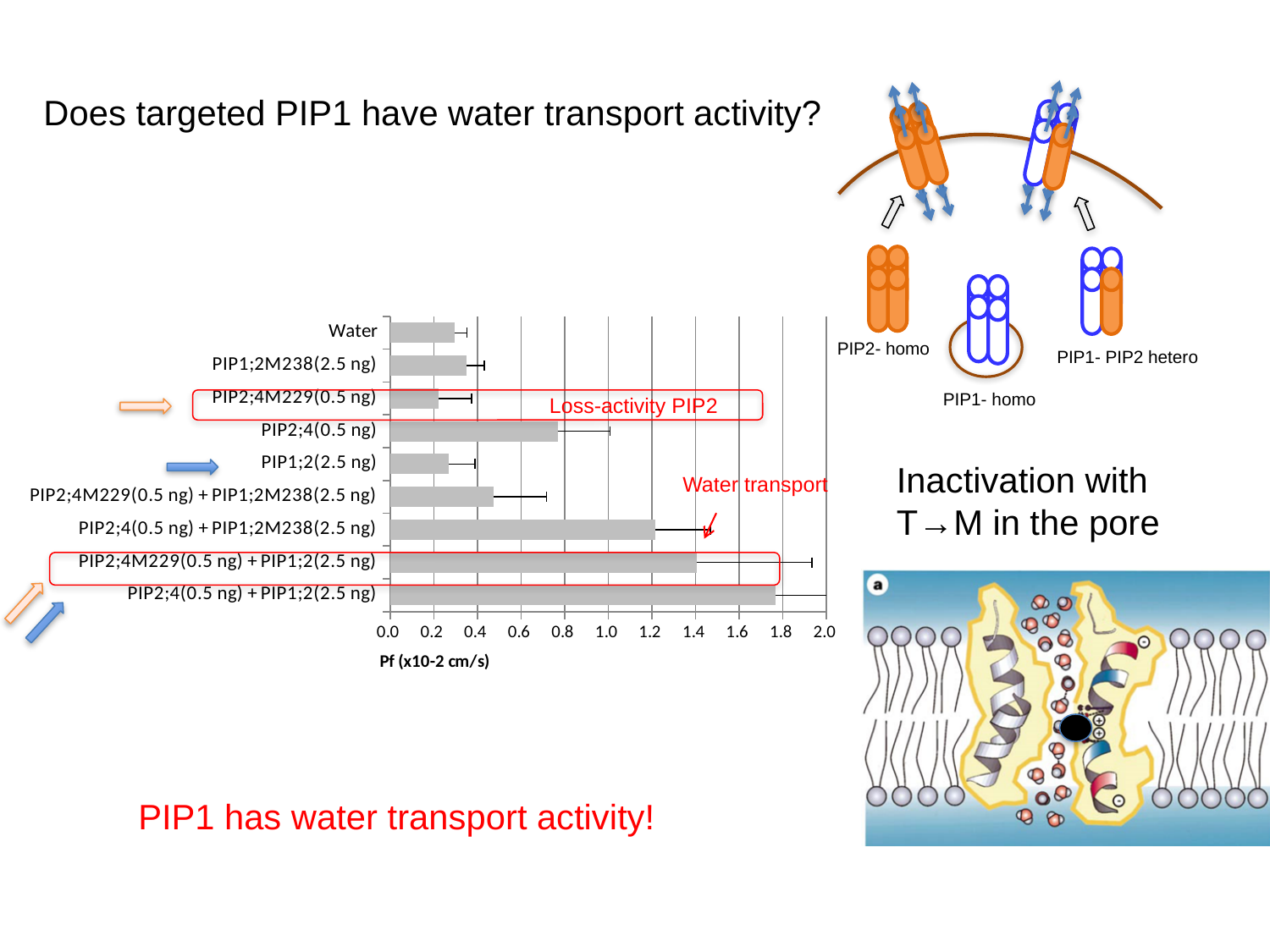
Is the value for PIP2;4(0.5 ng) + PIP1;2(2.5 ng) greater or less than 1.6? greater Is the value for PIP2;4(0.5 ng) + PIP1;2M238(2.5 ng) greater or less than 1.0? greater What kind of chart is shown on the slide? bar chart Is the value for PIP2;4(0.5 ng) greater or less than 0.6? greater Which is larger, the value for PIP2;4(0.5 ng) or the value for PIP2;4M229(0.5 ng)? PIP2;4(0.5 ng) What is the label of the horizontal axis of the chart? Pf (x10-2 cm/s) Which category has the highest Pf value? PIP2;4(0.5 ng) + PIP1;2(2.5 ng) How many categories (bars) does the chart show? 9 Which is larger, the value for PIP2;4(0.5 ng) + PIP1;2(2.5 ng) or the value for PIP2;4M229(0.5 ng) + PIP1;2M238(2.5 ng)? PIP2;4(0.5 ng) + PIP1;2(2.5 ng)